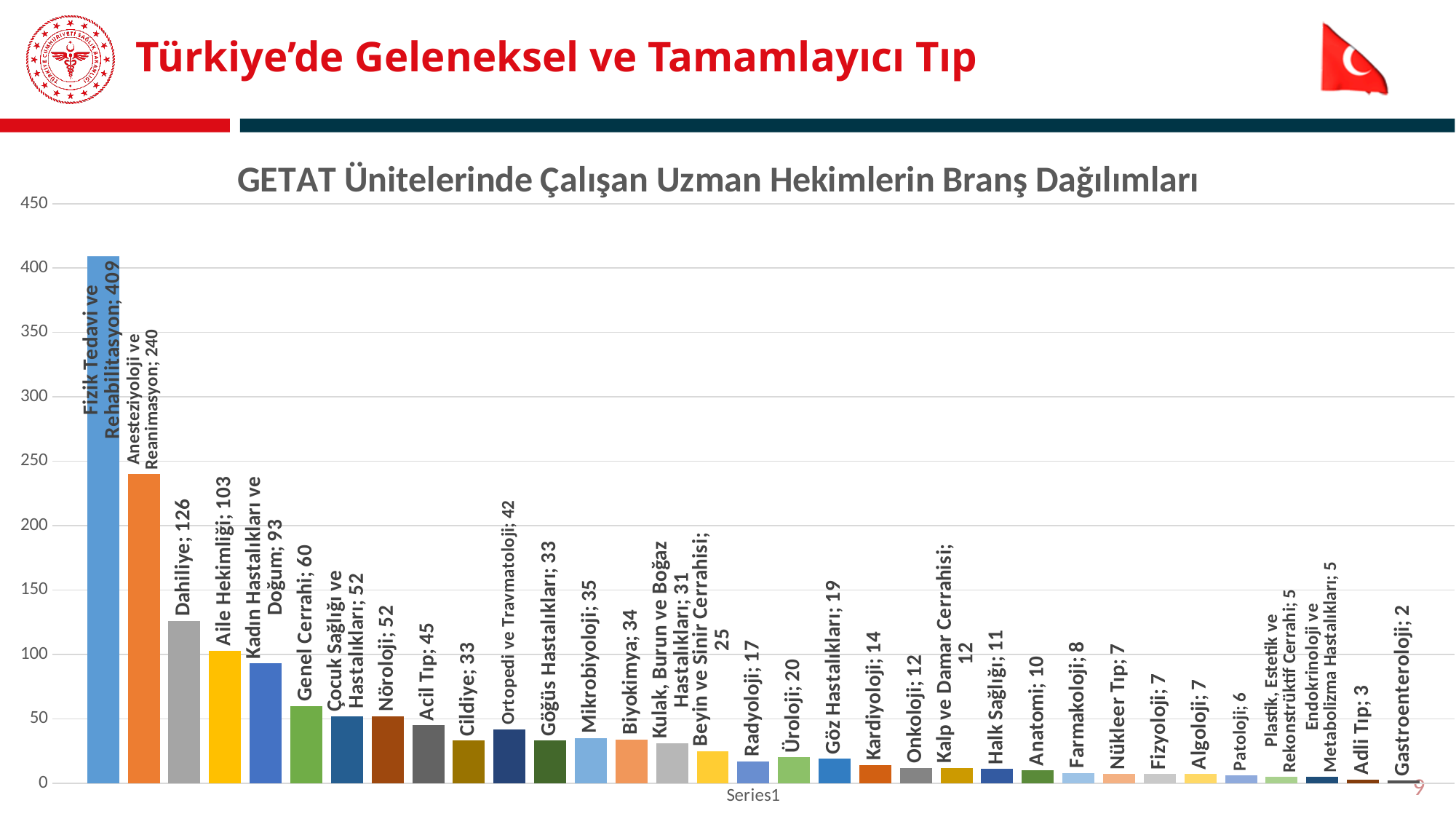
What is the value for Ortopedi ve Travmatoloji? 42 What is the value for Fizik Tedavi ve Rehabilitasyon? 409 Which branch has the lowest value? Gastroenteroloji Is the value for Kadın Hastalıkları ve Doğum greater or less than 100? less How many branches are shown in the chart? 33 What is the value for Gastroenteroloji? 2 Which branch has the highest value? Fizik Tedavi ve Rehabilitasyon Which is larger, Genel Cerrahi or Acil Tıp? Genel Cerrahi What is the difference between Anesteziyoloji ve Reanimasyon and Aile Hekimliği? 137 What is the title of the chart? GETAT Ünitelerinde Çalışan Uzman Hekimlerin Branş Dağılımları What kind of chart is this? bar chart What is the value for Dahiliye? 126